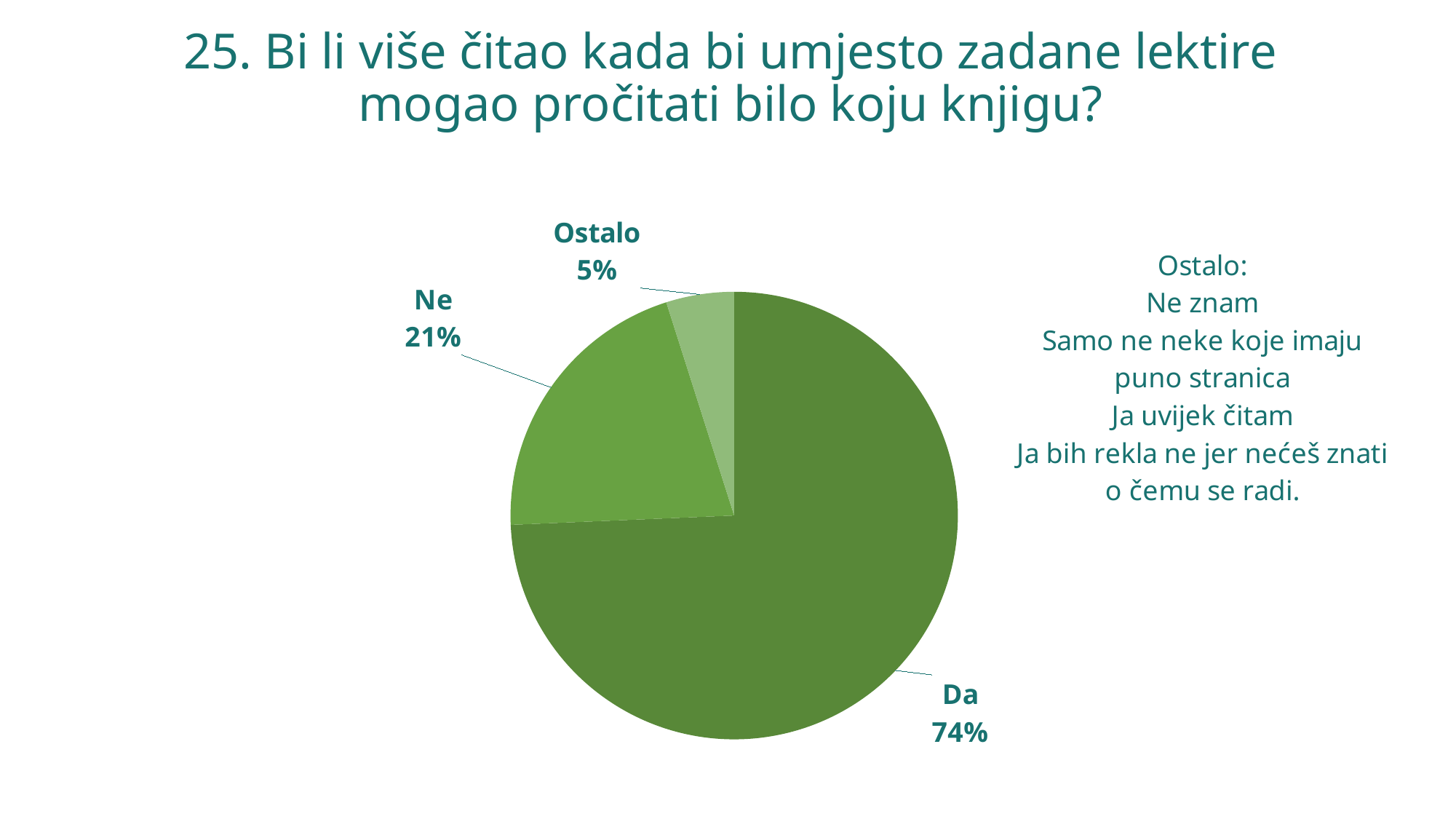
What share of the pie does the "Ne" slice represent? 21% What share of the pie does the "Ostalo" slice represent? 5% How many slices does the pie chart have? 3 What is the difference in percentage points between the "Ne" and "Ostalo" slices? 16 Is the share for "Da" greater or less than 50%? greater What is the title of the chart on the slide? 25. Bi li više čitao kada bi umjesto zadane lektire mogao pročitati bilo koju knjigu? Which slice of the pie is the smallest? Ostalo Which slice of the pie is the largest? Da What share of the pie does the "Da" slice represent? 74% Which slice is larger, "Ne" or "Ostalo"? Ne What kind of chart is shown on the slide? pie chart What is the difference in percentage points between the "Da" and "Ne" slices? 53